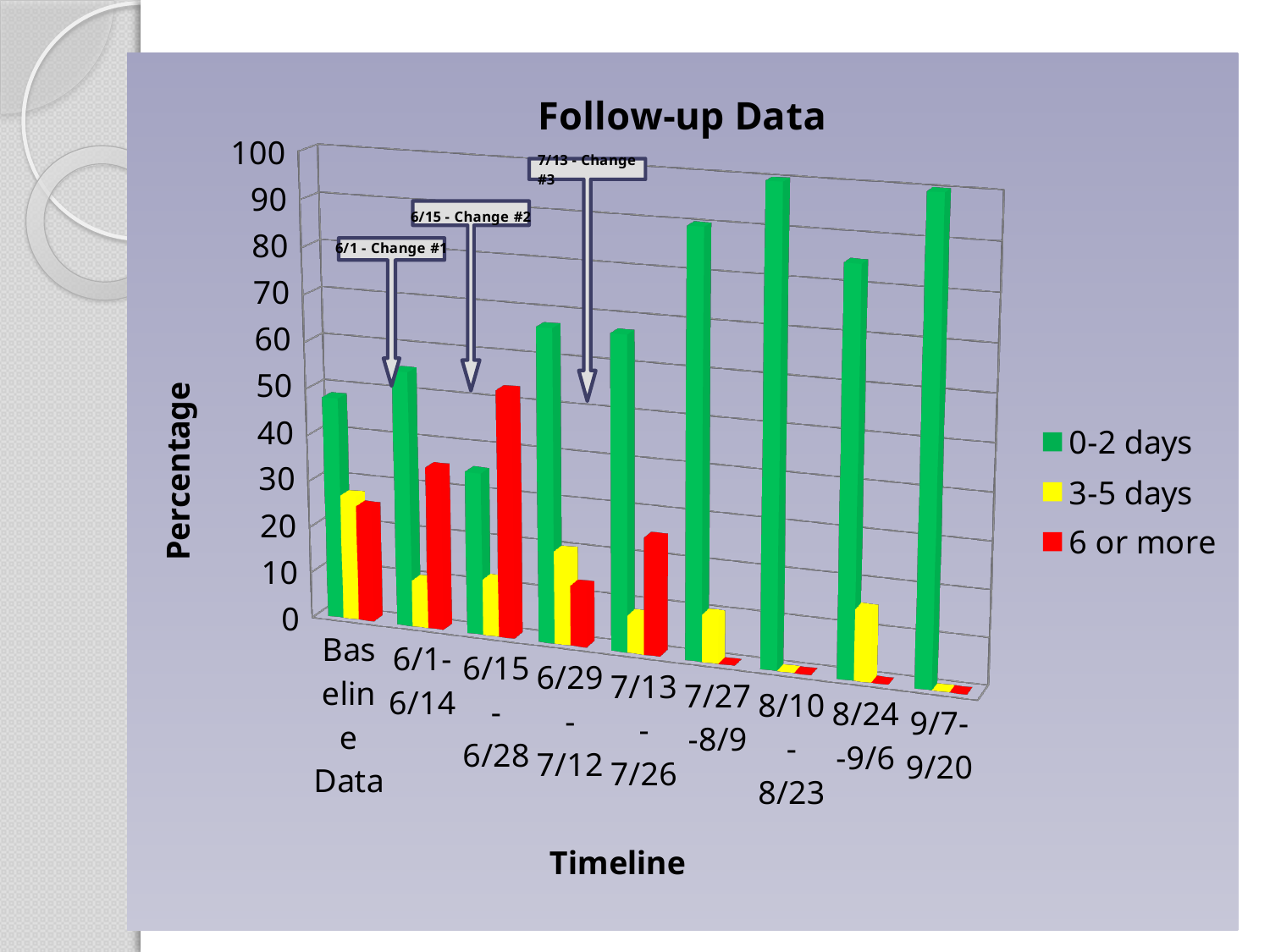
Which is larger: the 0-2 days value for 7/27-8/9 or for 6/29-7/12? 7/27-8/9 How many series does the legend list? 3 Which series is shown in red in the legend? 6 or more Is the 6 or more value for 6/15-6/28 greater or less than 40? greater How many time-period categories are shown on the x axis? 9 What type of chart is shown on the slide? Bar chart Which category has the lowest value for the 0-2 days series? 6/15-6/28 Is the 0-2 days value for 6/15-6/28 greater or less than 40? less Is the 0-2 days value for 7/27-8/9 greater or less than 70? greater In the 6/15-6/28 period, which is larger: the 0-2 days value or the 6 or more value? 6 or more Which category has the highest value for the 6 or more series? 6/15-6/28 What is the title of the chart? Follow-up Data